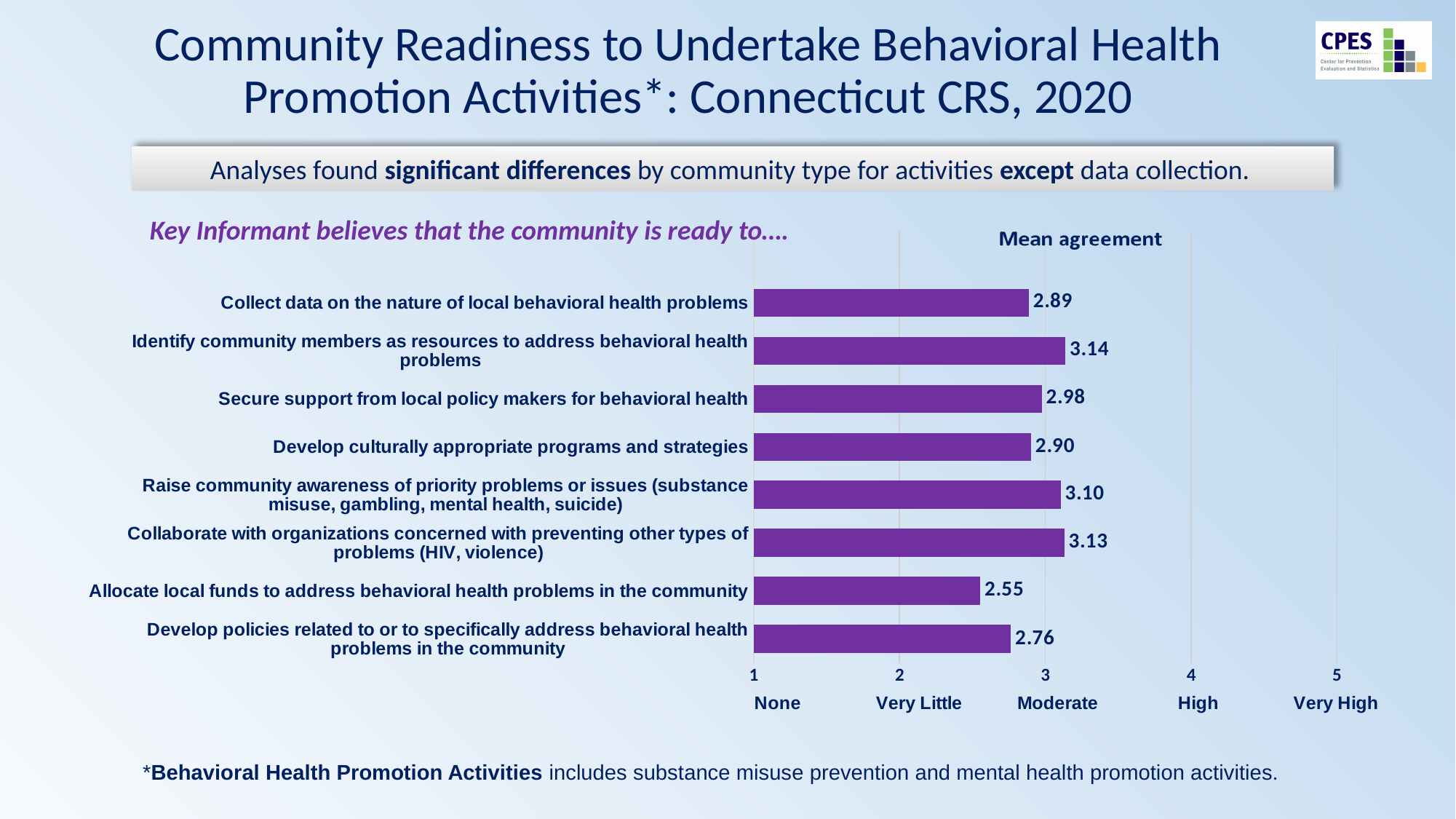
What is the difference in mean agreement between 'Identify community members as resources to address behavioral health problems' and 'Allocate local funds to address behavioral health problems in the community'? 0.59 What is the mean agreement for 'Allocate local funds to address behavioral health problems in the community'? 2.55 What is the mean agreement for 'Secure support from local policy makers for behavioral health'? 2.98 What kind of chart is shown on the slide? Bar chart Which has a higher mean agreement: 'Develop culturally appropriate programs and strategies' or 'Develop policies related to or to specifically address behavioral health problems in the community'? Develop culturally appropriate programs and strategies What label on the x axis corresponds to the value 3? Moderate What is the mean agreement for 'Collect data on the nature of local behavioral health problems'? 2.89 How many activities are shown in the chart? 8 What is the difference in mean agreement between 'Collaborate with organizations concerned with preventing other types of problems (HIV, violence)' and 'Develop policies related to or to specifically address behavioral health problems in the community'? 0.37 Is the mean agreement for 'Raise community awareness of priority problems or issues' greater or less than 3? greater Which activity has the highest mean agreement? Identify community members as resources to address behavioral health problems Which activity has the lowest mean agreement? Allocate local funds to address behavioral health problems in the community